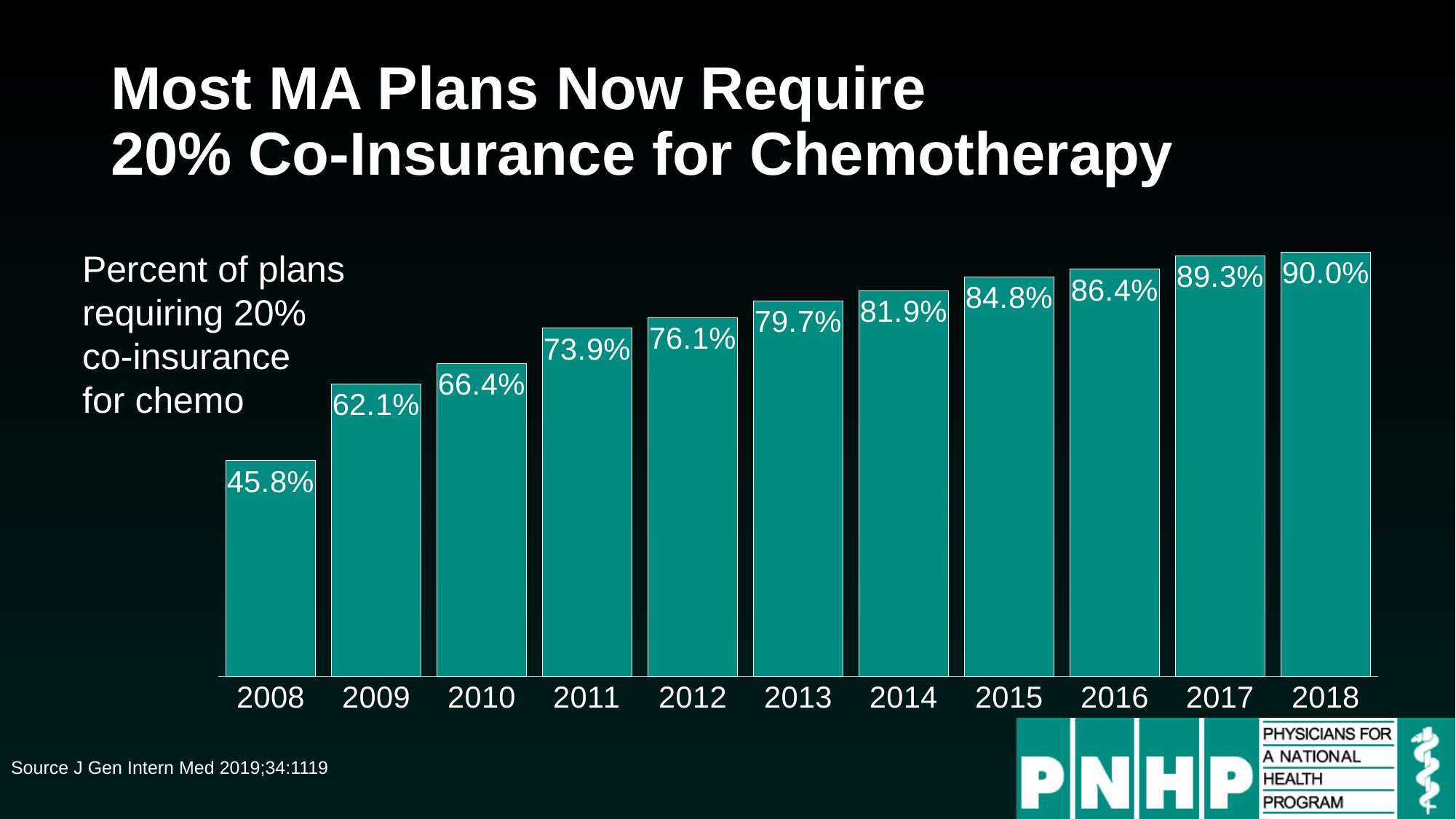
Which year has the highest percent of plans requiring 20% co-insurance for chemo? 2018 Do the values rise or fall from 2008 to 2018? Rise What colour are the bars in the chart? Teal Which year has the lowest percent of plans requiring 20% co-insurance for chemo? 2008 What percent of plans required 20% co-insurance for chemo in 2008? 45.8% What percent of plans required 20% co-insurance for chemo in 2018? 90.0% What is the difference in percentage points between the 2018 and 2008 values? 44.2 percentage points What is the value shown for 2013? 79.7% What kind of chart is shown on the slide? Bar chart Which year has a higher value, 2011 or 2015? 2015 What is the difference between the 2010 and 2009 values? 4.3 percentage points How many years are shown on the x axis? 11